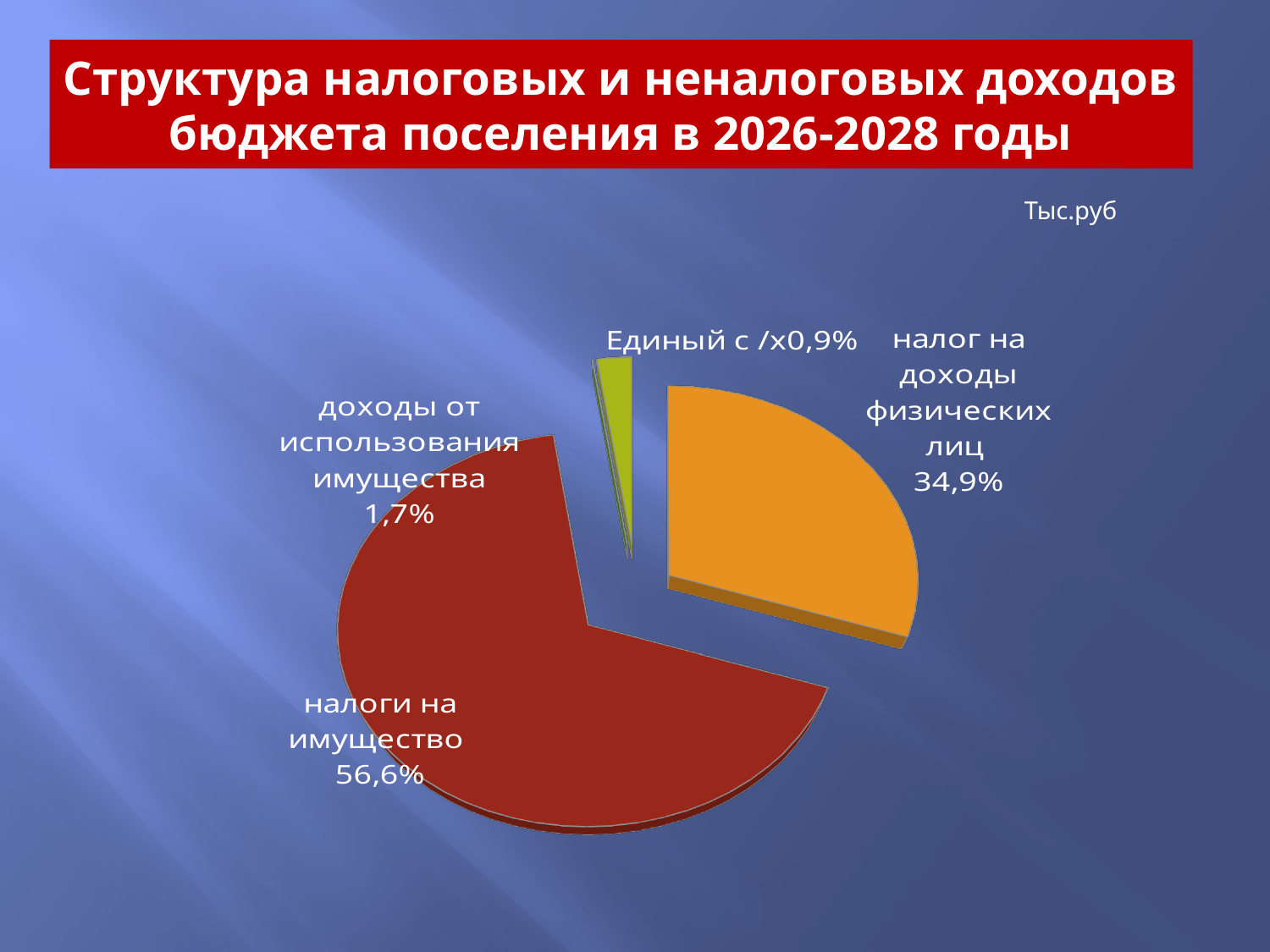
What is the difference in percentage points between "налоги на имущество" and "налог на доходы физических лиц"? 21,7 What share of the pie does "налоги на имущество" have? 56,6% Which category has the smallest share of the pie? Единый с/х Which is larger: the share for "доходы от использования имущества" or the share for "Единый с/х"? доходы от использования имущества What is the title of the chart on the slide? Структура налоговых и неналоговых доходов бюджета поселения в 2026-2028 годы What share of the pie does "Единый с/х" have? 0,9% What kind of chart is shown on the slide? pie chart What share of the pie does "налог на доходы физических лиц" have? 34,9% Which category has the largest share of the pie? налоги на имущество What share of the pie does "доходы от использования имущества" have? 1,7% What colour is the slice for "налог на доходы физических лиц"? orange